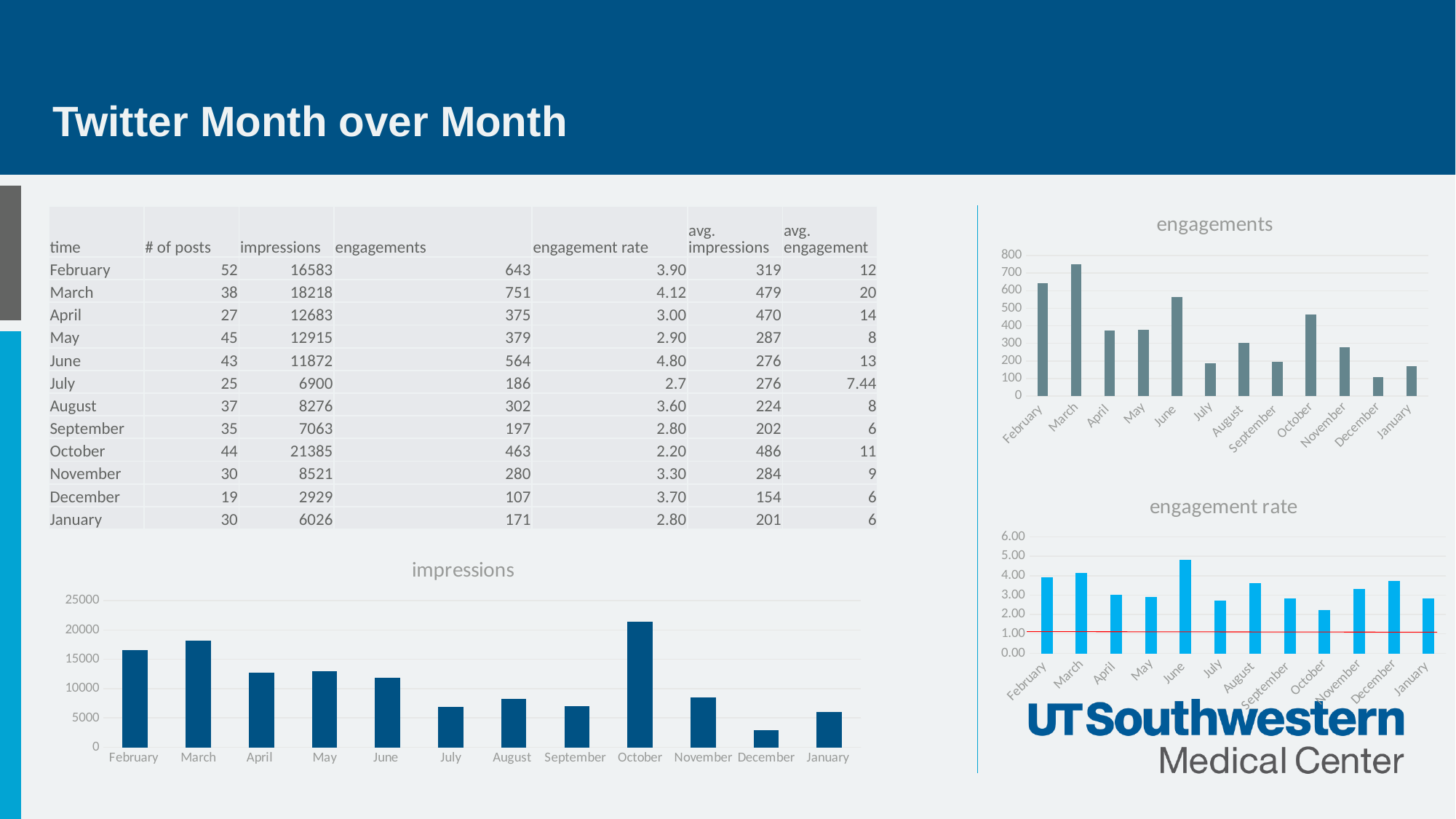
In the "engagement rate" chart, which month has the highest value? June In the "impressions" chart, which month has the highest value? October In the "engagement rate" chart, is the value for October greater or less than 3.00? less In the "engagements" chart, which is larger, February or October? February What kind of chart is the "impressions" chart? bar chart In the "engagements" chart, which month has the highest value? March In the "engagements" chart, which month has the lowest value? December How many charts are shown on the slide? 3 In the "engagements" chart, is the value for June greater or less than 500? greater In the "impressions" chart, which month has the lowest value? December How many months are plotted in the "impressions" chart? 12 In the "impressions" chart, is the value for October greater or less than 20000? greater